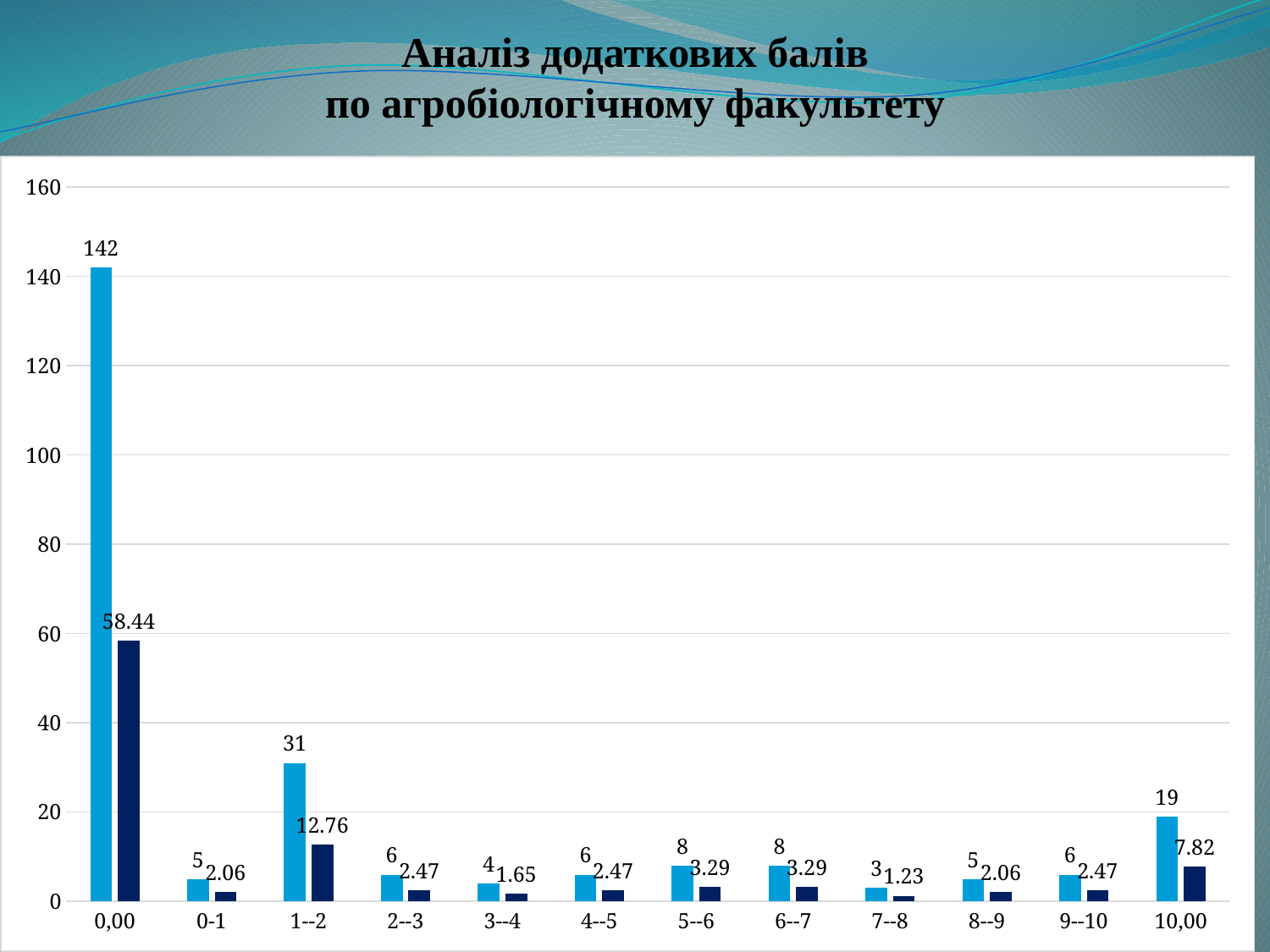
What is the value of the dark blue bar for the category 1--2? 12.76 Which category has the highest light blue bar? 0,00 What is the difference between the light blue bars for 0,00 and 1--2? 111 How many categories are shown on the x axis? 12 What is the value of the light blue bar for the category 0,00? 142 What is the title of the chart on the slide? Аналіз додаткових балів по агробіологічному факультету Is the value of the light blue bar for 0,00 greater or less than 140? greater What is the value of the light blue bar for the category 10,00? 19 Which is larger: the light blue bar for 10,00 or the light blue bar for 5--6? 10,00 What type of chart is shown on the slide? bar chart What is the value of the dark blue bar for the category 7--8? 1.23 Which category has the lowest light blue bar? 7--8